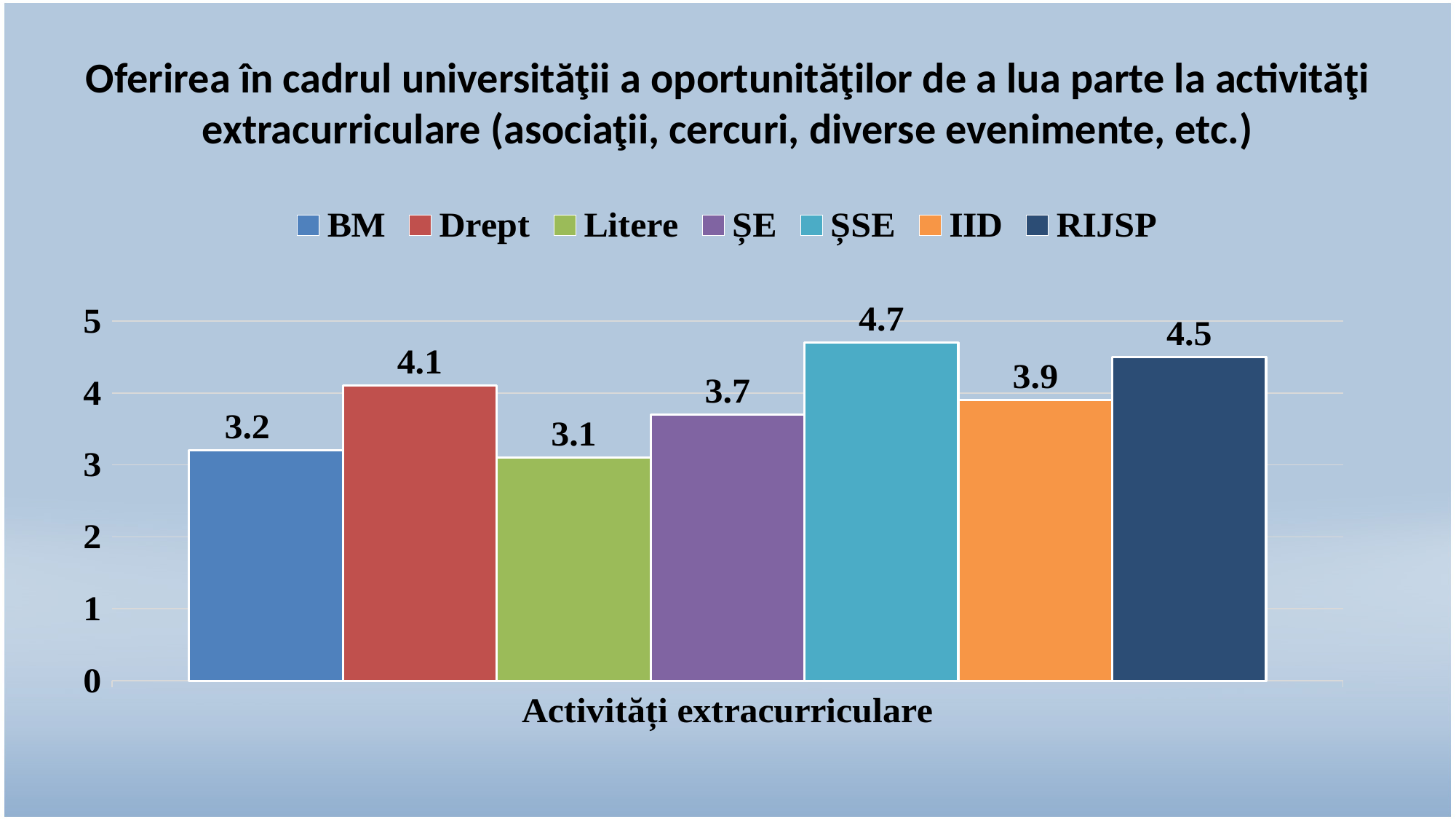
What is the value for IID? 3.9 What is the value for Drept? 4.1 Which series has the highest value? ȘSE What is the difference between the values for ȘSE and ȘE? 1 Which is larger, the value for Drept or the value for IID? Drept What is the value for ȘSE? 4.7 Which series has the lowest value? Litere What is the difference between the values for RIJSP and BM? 1.3 What is the label on the x axis of the chart? Activități extracurriculare Is the value for ȘE greater or less than 4? less What kind of chart is shown on the slide? bar chart How many series does the legend list? 7